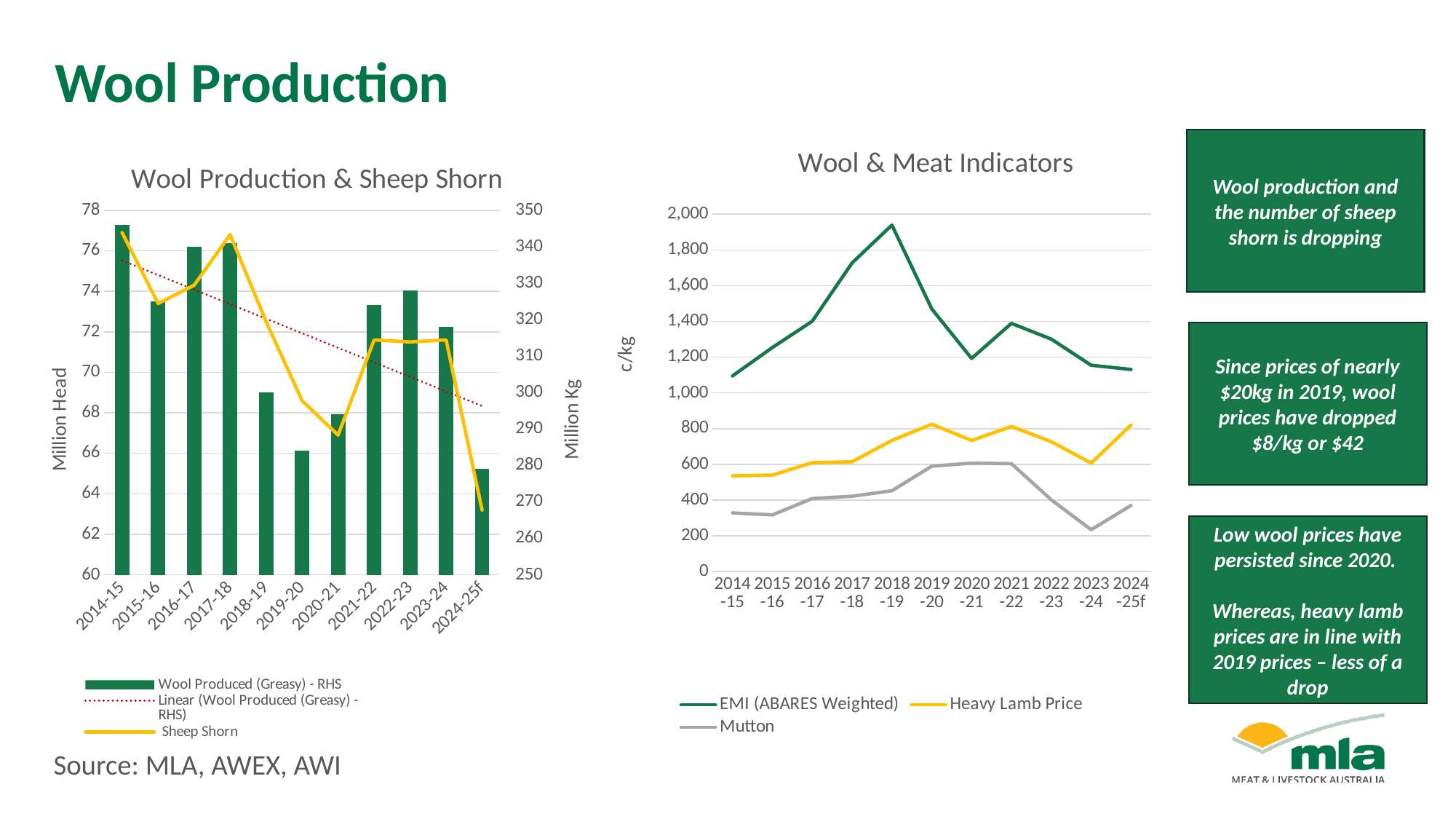
In the 'Wool & Meat Indicators' chart, in which year is the Mutton series at its lowest? 2023-24 How many series does the legend of the 'Wool & Meat Indicators' chart list? 3 What type of chart is the 'Wool & Meat Indicators' chart? line chart In the 'Wool & Meat Indicators' chart, which series is higher in 2018-19: EMI (ABARES Weighted) or Heavy Lamb Price? EMI (ABARES Weighted) In the 'Wool & Meat Indicators' chart, is the EMI (ABARES Weighted) value for 2018-19 greater or less than 1,800? greater How many years are plotted on the x axis of the 'Wool & Meat Indicators' chart? 11 In the 'Wool & Meat Indicators' chart, in which year does the EMI (ABARES Weighted) series reach its highest value? 2018-19 In the 'Wool & Meat Indicators' chart, is the Mutton value for 2023-24 greater or less than 300? less How many entries does the legend of the 'Wool Production & Sheep Shorn' chart list? 3 In the 'Wool Production & Sheep Shorn' chart, which year has the tallest Wool Produced (Greasy) bar? 2014-15 In the 'Wool Production & Sheep Shorn' chart, which year has the shortest Wool Produced (Greasy) bar? 2024-25f